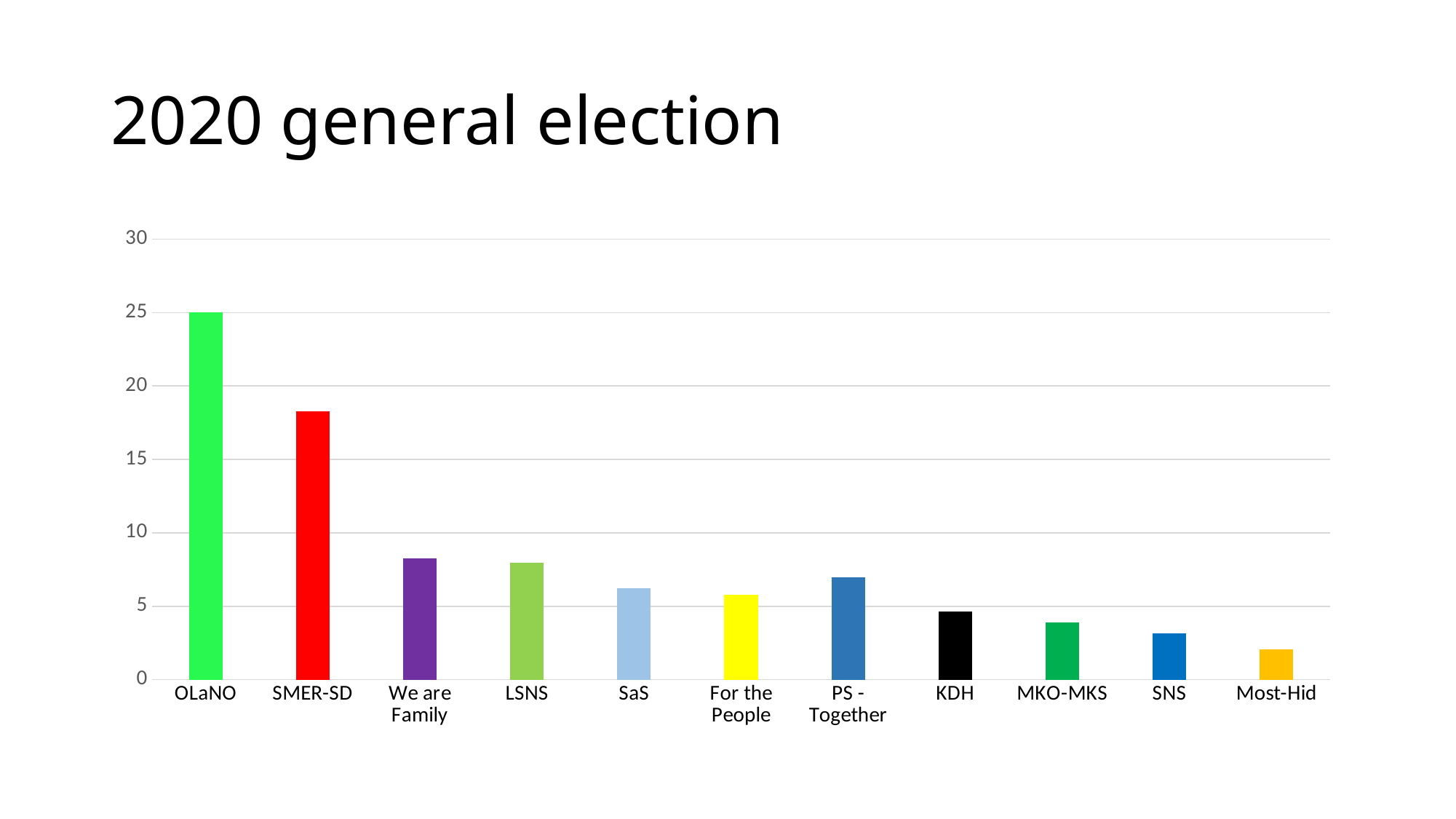
What is the value for OLaNO? 25 How many parties are shown on the x axis of the chart? 11 Is the value for SMER-SD greater or less than 15? greater Do the values generally rise or fall from left to right along the x axis? fall Which party has the highest bar in the chart? OLaNO Which is larger, the value for SaS or the value for SNS? SaS Is the value for KDH greater or less than 5? less Is the value for PS - Together greater or less than 5? greater What kind of chart is shown on the slide? bar chart What is the title of the slide? 2020 general election Which party has the lowest bar in the chart? Most-Hid